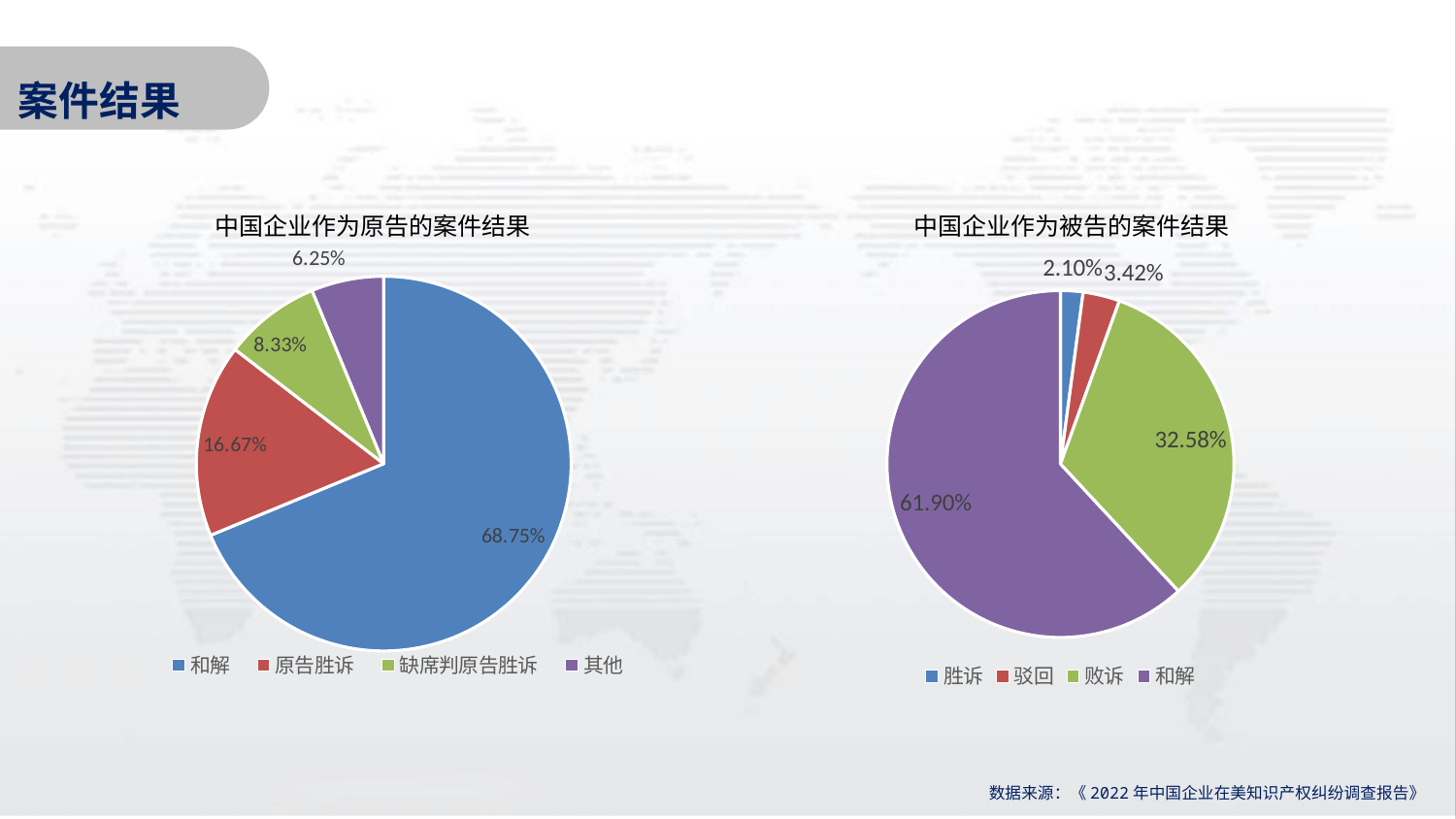
In the chart titled 中国企业作为被告的案件结果, which is larger, 驳回 or 胜诉? 驳回 In the chart titled 中国企业作为被告的案件结果, which category has the smallest slice? 胜诉 In the chart titled 中国企业作为原告的案件结果, which category has the smallest slice? 其他 What type of chart is the chart titled 中国企业作为原告的案件结果? Pie chart In the chart titled 中国企业作为被告的案件结果, what share does 和解 have? 61.90% In the chart titled 中国企业作为原告的案件结果, what is the value for 缺席判原告胜诉? 8.33% In the chart titled 中国企业作为原告的案件结果, what share does 和解 have? 68.75% In the chart titled 中国企业作为原告的案件结果, how many slices does the pie have? 4 In the chart titled 中国企业作为被告的案件结果, what is the value for 败诉? 32.58% In the chart titled 中国企业作为被告的案件结果, what is the difference between 和解 and 败诉? 29.32% In the chart titled 中国企业作为原告的案件结果, what is the value for 原告胜诉? 16.67% In the chart titled 中国企业作为被告的案件结果, how many entries does the legend list? 4